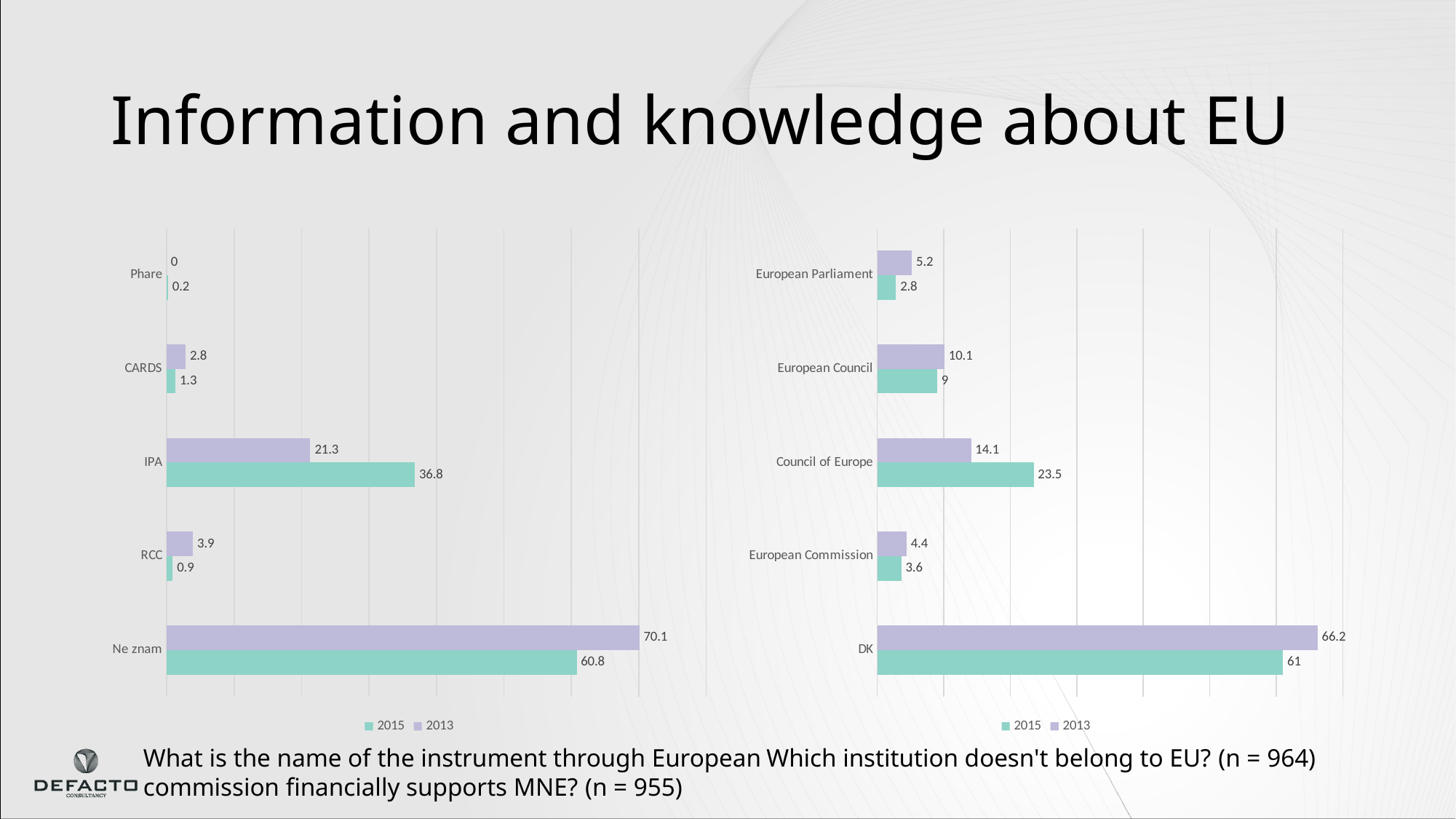
In the right chart, what is the 2015 value for Council of Europe? 23.5 In the left chart, what is the 2013 value for Ne znam? 70.1 What type of chart is the left chart? Bar chart In the left chart, which category has the highest 2013 value? Ne znam In the right chart, what is the 2013 value for European Council? 10.1 How many categories are shown in the left chart? 5 In the right chart, which is larger for European Commission: the 2013 value or the 2015 value? 2013 In the right chart, which category has the lowest 2015 value? European Parliament In the left chart, what is the 2015 value for IPA? 36.8 In the right chart, what is the difference between the 2013 and 2015 values for DK? 5.2 How many series does the legend of the right chart list? 2 In the left chart, what is the difference between the 2015 and 2013 values for IPA? 15.5